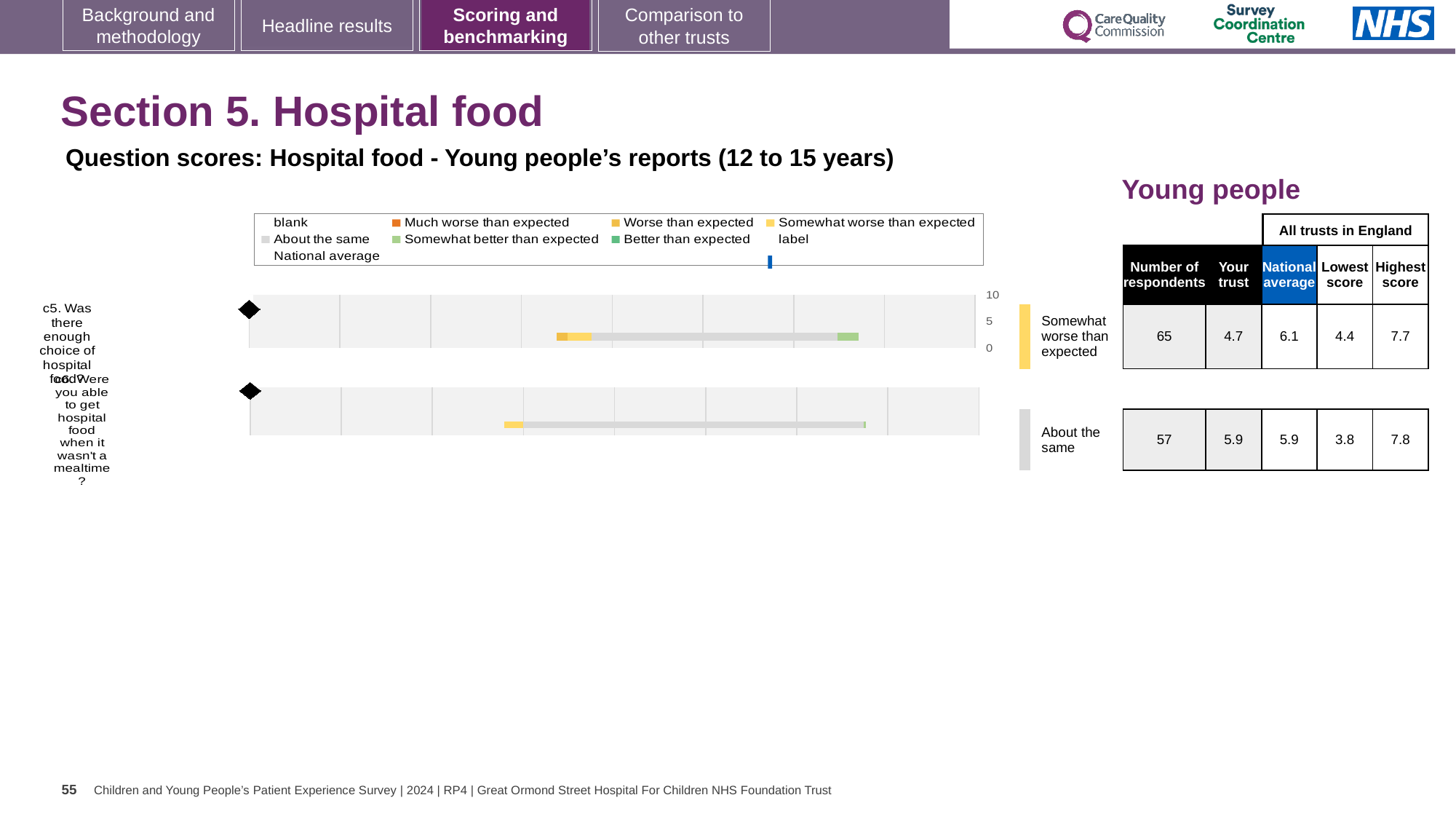
Which benchmark category is c5 (Was there enough choice of hospital food?) placed in? Somewhat worse than expected What is the national average score for c5 (Was there enough choice of hospital food?)? 6.1 How many questions (categories) are plotted in the hospital food chart? 2 What is the lowest score among all trusts in England for c5? 4.4 What is the highest score among all trusts in England for c6? 7.8 What is the 'Your trust' score for c5 (Was there enough choice of hospital food?)? 4.7 For c5, which is larger: the 'Your trust' score or the national average? National average What kind of chart is used to show the question scores for hospital food? bar chart How many respondents answered c6 (Were you able to get hospital food when it wasn't a mealtime?)? 57 What is the difference between the national average and the 'Your trust' score for c5? 1.4 Which benchmark category is c6 (Were you able to get hospital food when it wasn't a mealtime?) placed in? About the same What does the blue marker in the chart legend represent? National average